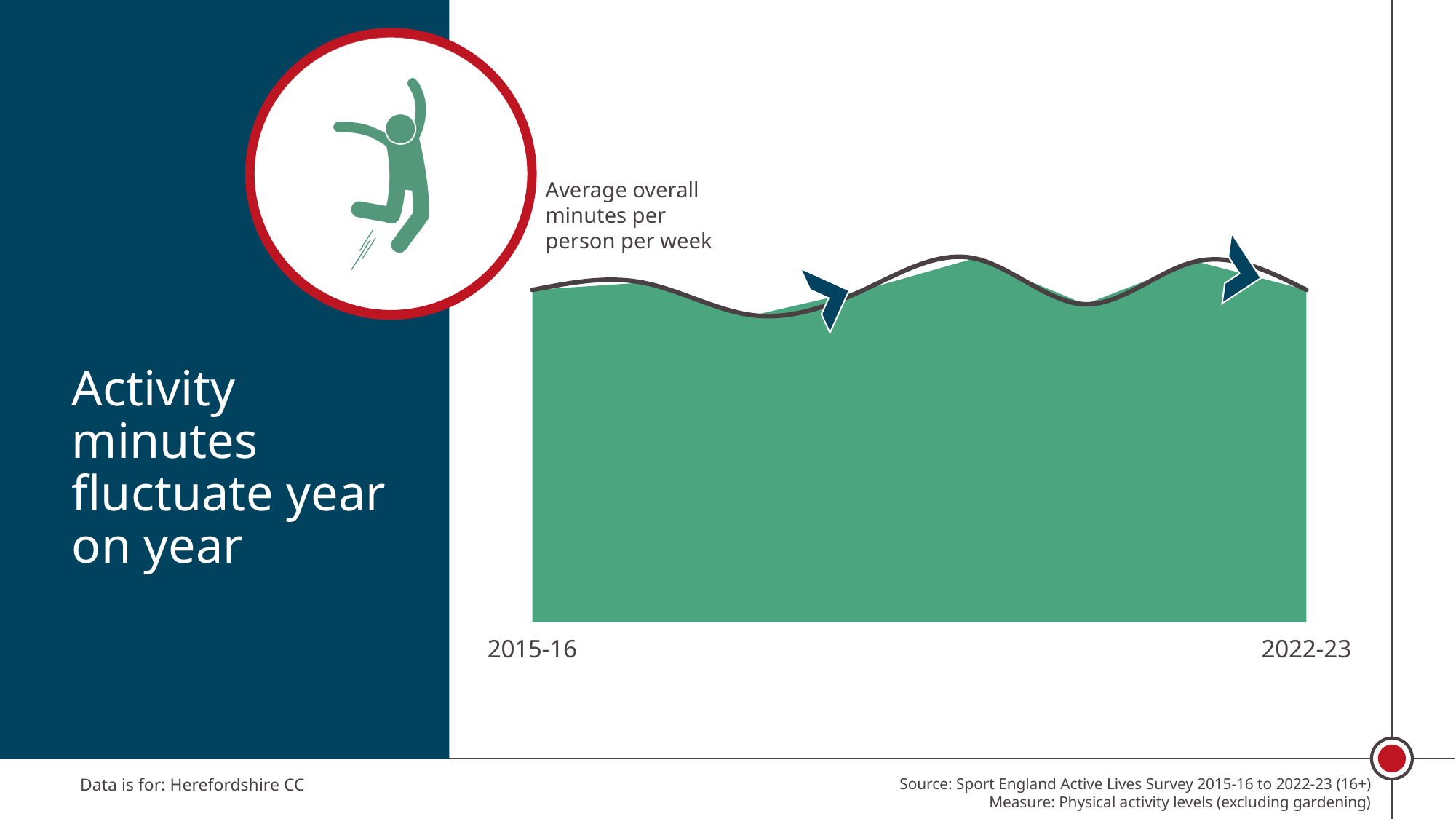
What is the first year label shown on the x axis of the chart? 2015-16 Do the values rise steadily, fall steadily, or fluctuate across the years shown on the x axis? Fluctuate What kind of chart is shown on the slide? Area chart What measure does the chart plot, according to the label above it? Average overall minutes per person per week